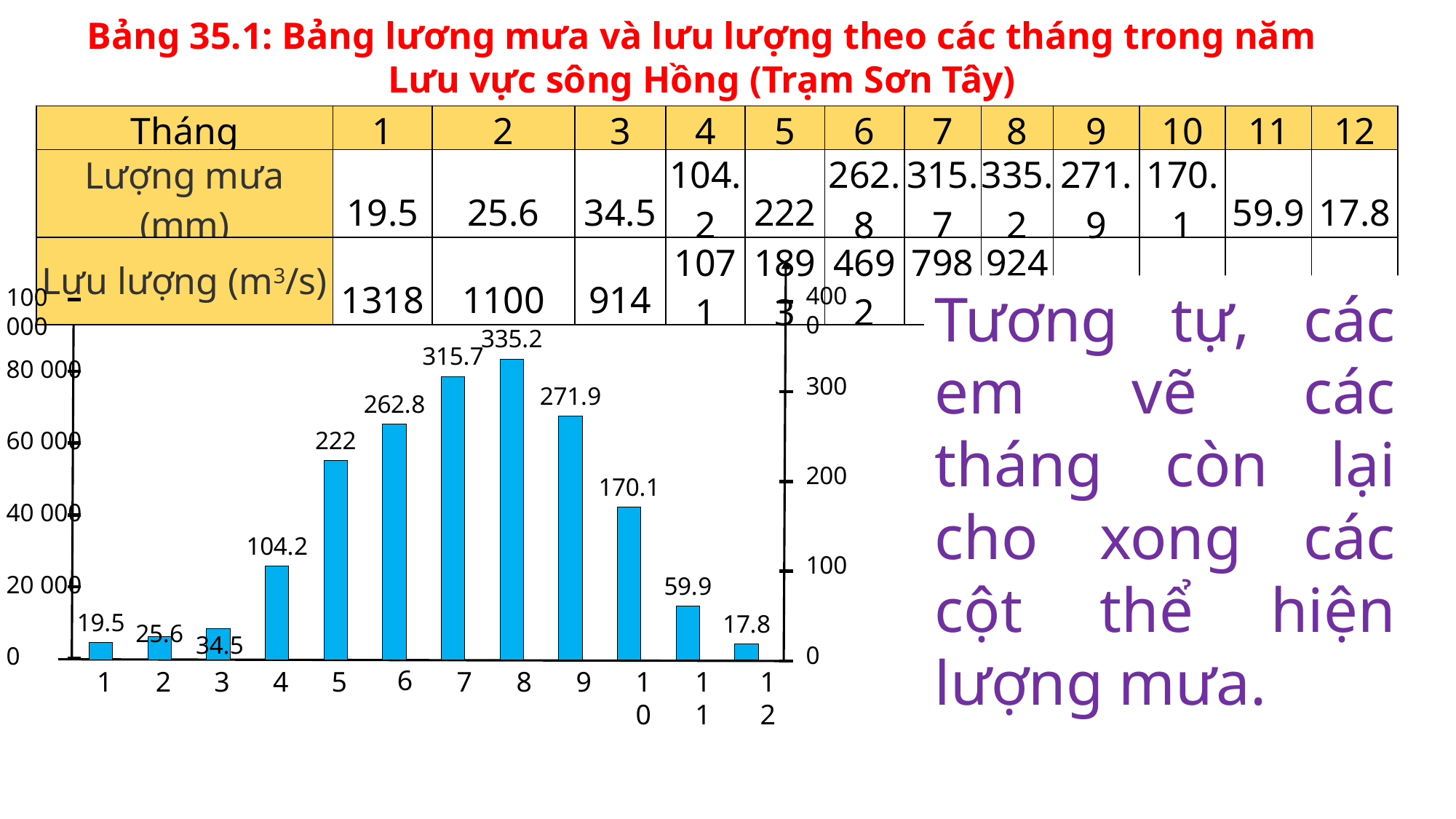
What is the rainfall value shown for month 5 in the chart? 222 Do the bar values rise or fall from month 1 to month 8 in the chart? rise Which month has the lowest bar in the chart? 12 What is the rainfall value shown for month 12 in the chart? 17.8 What is the difference between the values for month 10 and month 11 in the chart? 110.2 What kind of chart is shown on the slide? bar chart What is the rainfall value shown for month 8 in the chart? 335.2 What colour are the bars in the chart? blue What is the difference between the values for month 8 and month 7 in the chart? 19.5 Which is larger in the chart, the value for month 6 or the value for month 9? month 9 Which month has the highest bar in the chart? 8 How many months (bars) are plotted in the chart? 12